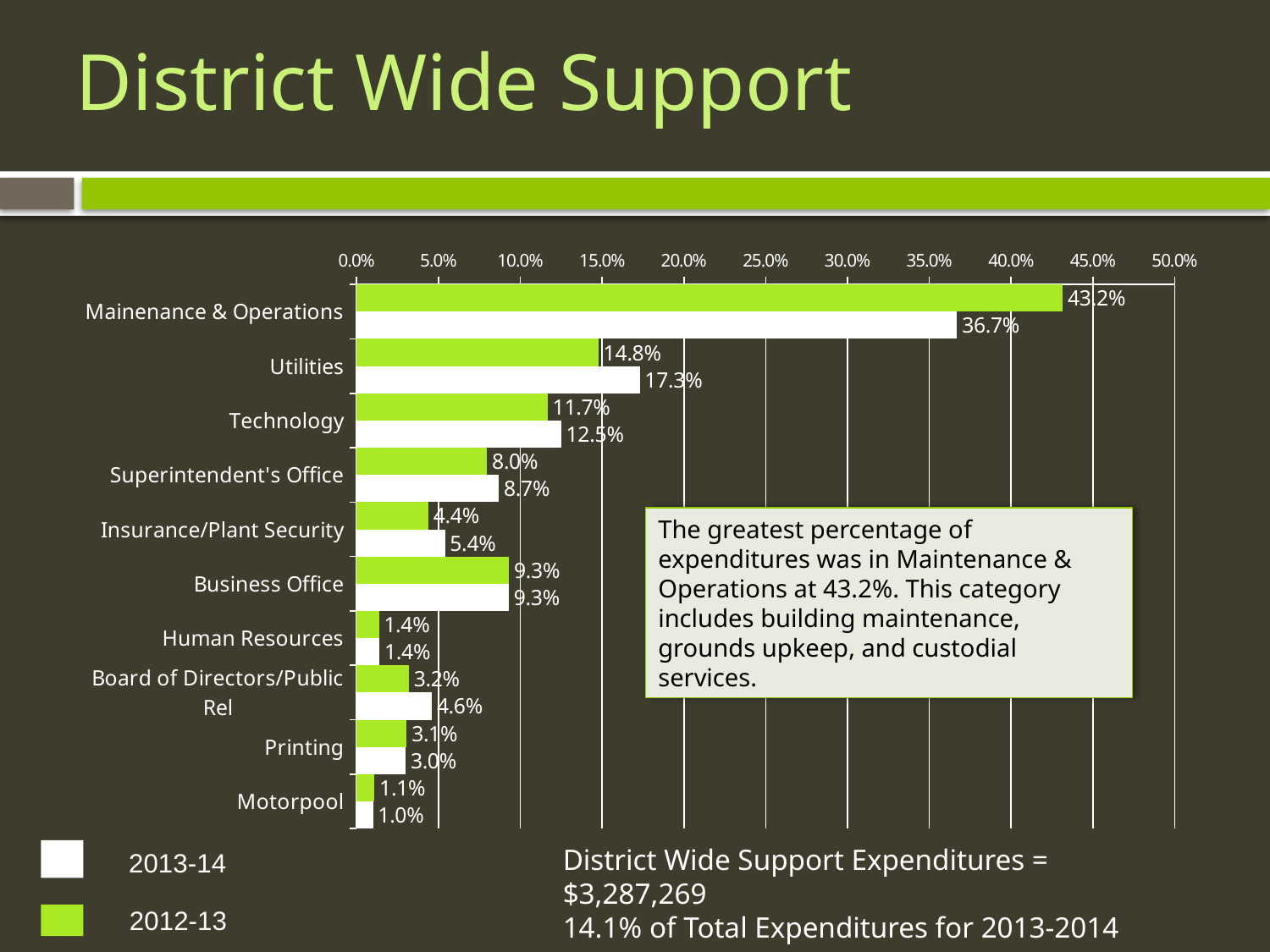
What is the 2013-14 value for Utilities? 17.3% What is the 2013-14 value for Board of Directors/Public Rel? 4.6% What is the 2012-13 value for Insurance/Plant Security? 4.4% What kind of chart is shown on the slide? Bar chart What is the 2012-13 value for Mainenance & Operations? 43.2% How many series does the legend list? 2 Which colour represents the 2012-13 series? Green Which category has the lowest 2013-14 value? Motorpool Which is larger for Technology, the 2012-13 value or the 2013-14 value? 2013-14 How many categories are shown on the chart? 10 What is the difference between the 2012-13 and 2013-14 values for Mainenance & Operations? 6.5% Which category has the highest 2013-14 value? Mainenance & Operations